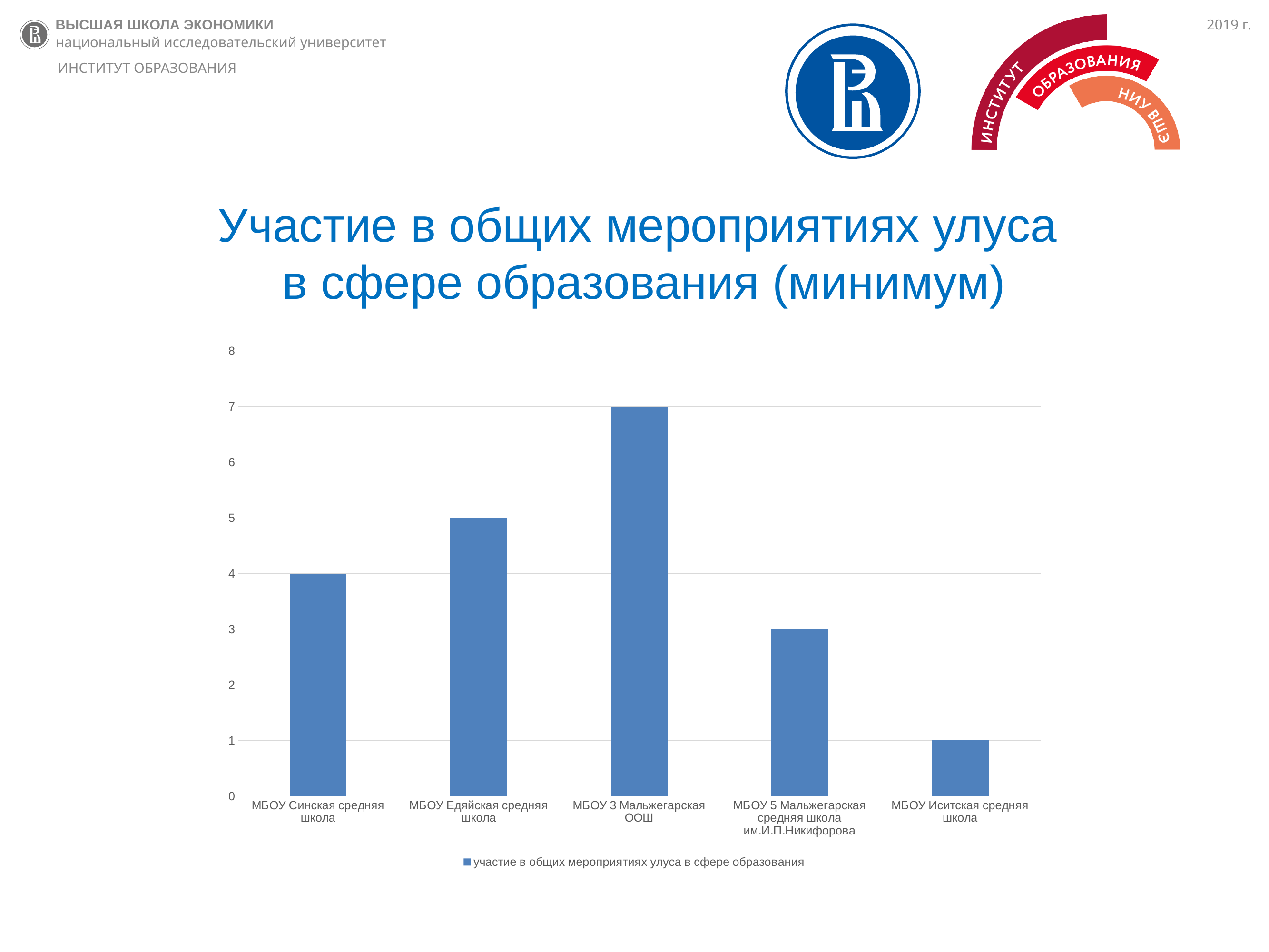
Is the value for МБОУ 5 Мальжегарская средняя школа им.И.П.Никифорова greater or less than 5? less How many schools are shown on the chart? 5 What is the difference between the values for МБОУ 3 Мальжегарская ООШ and МБОУ 5 Мальжегарская средняя школа им.И.П.Никифорова? 4 What is the value for МБОУ 3 Мальжегарская ООШ? 7 What is the value for МБОУ Синская средняя школа? 4 Which school has the lowest value? МБОУ Иситская средняя школа How many series does the legend list? 1 Which school has the highest value? МБОУ 3 Мальжегарская ООШ What is the value for МБОУ Иситская средняя школа? 1 What is the legend entry of the chart? участие в общих мероприятиях улуса в сфере образования Which is larger, the value for МБОУ Едяйская средняя школа or the value for МБОУ Синская средняя школа? МБОУ Едяйская средняя школа What kind of chart is shown on the slide? bar chart